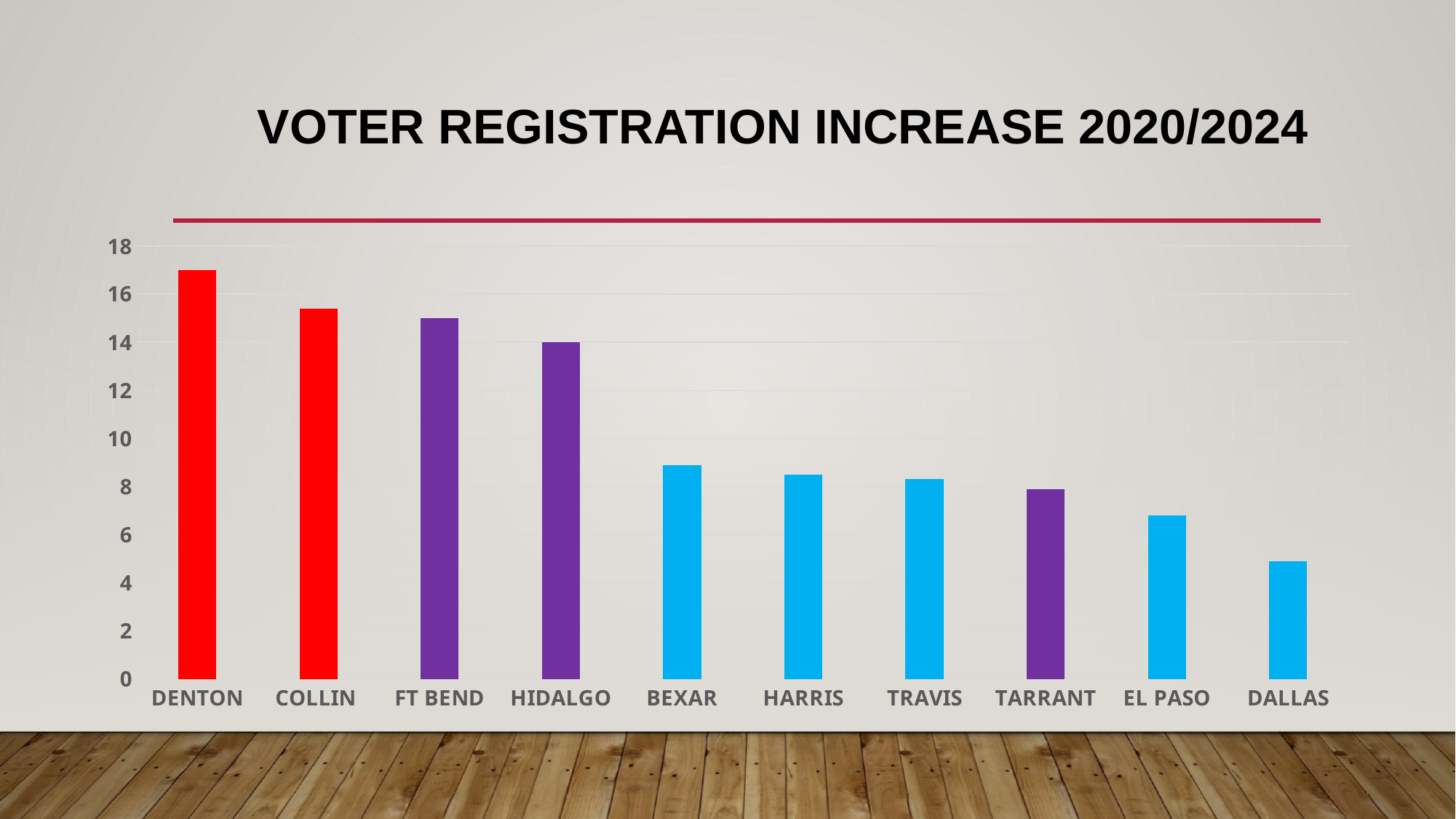
Do the bar values generally rise or fall from left to right along the x axis? fall What is the title of the chart? Voter Registration Increase 2020/2024 Is the value for Denton greater or less than 16? greater Is the value for Bexar greater or less than 10? less Is the value for Dallas greater or less than 6? less Which is larger, the value for Collin or the value for Harris? Collin What colour are the bars for Denton and Collin? red Which county has the lowest bar in the chart? Dallas Which county has the highest bar in the chart? Denton What kind of chart is shown on the slide? bar chart How many counties are shown on the x axis of the chart? 10